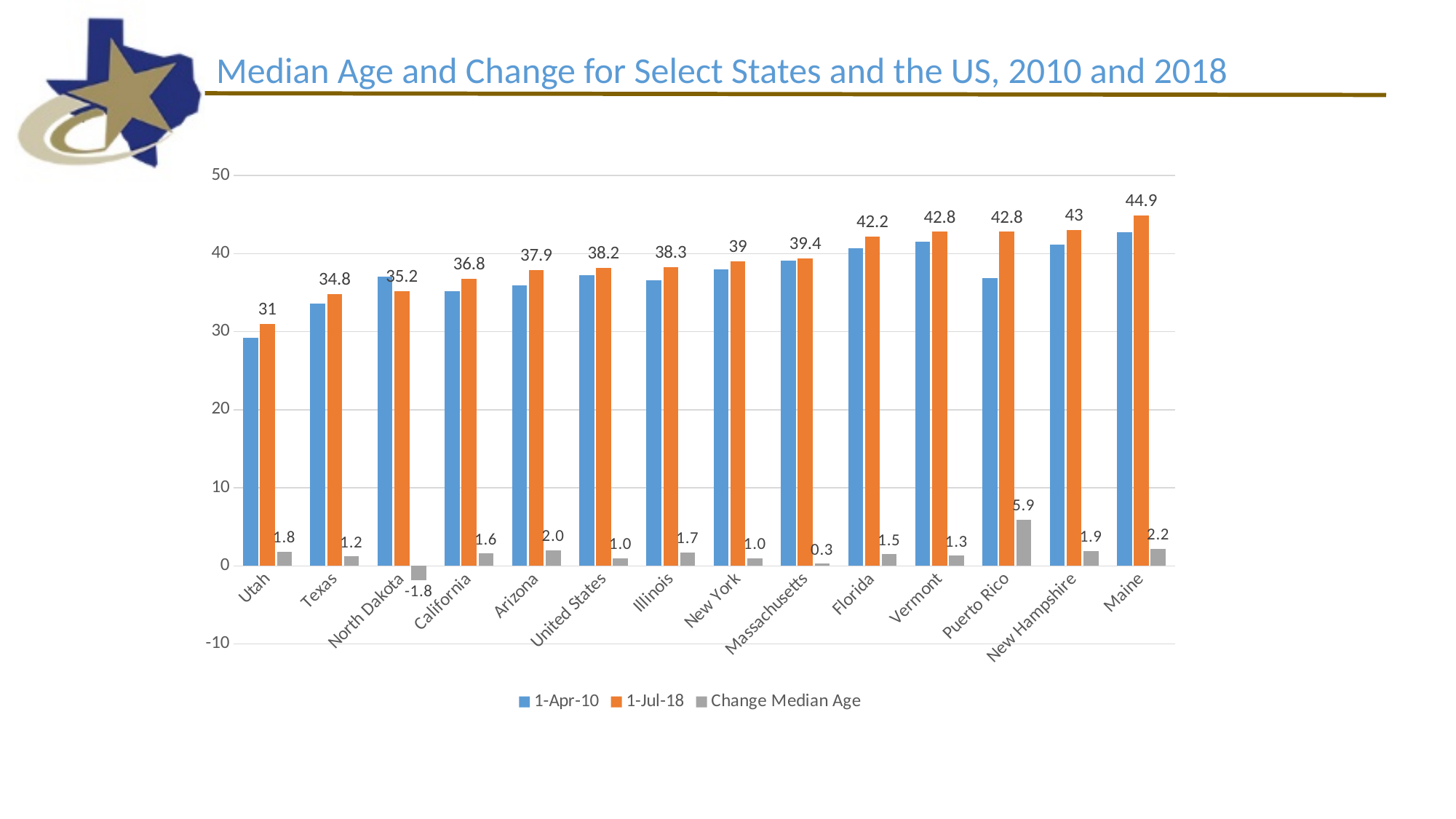
How many categories are shown on the x axis? 14 What is the Change Median Age value for Puerto Rico? 5.9 What kind of chart is shown on the slide? bar chart What is the difference between the 1-Jul-18 median age for Maine and for Utah? 13.9 What is the 1-Jul-18 median age value for Texas? 34.8 Which category has the highest 1-Jul-18 median age? Maine Which has a larger Change Median Age value, Arizona or Massachusetts? Arizona What is the Change Median Age value for North Dakota? -1.8 How many series does the legend list? 3 Which category has the lowest 1-Jul-18 median age? Utah Which category has the lowest Change Median Age value? North Dakota Is the 1-Apr-10 value for Utah greater or less than 30? less